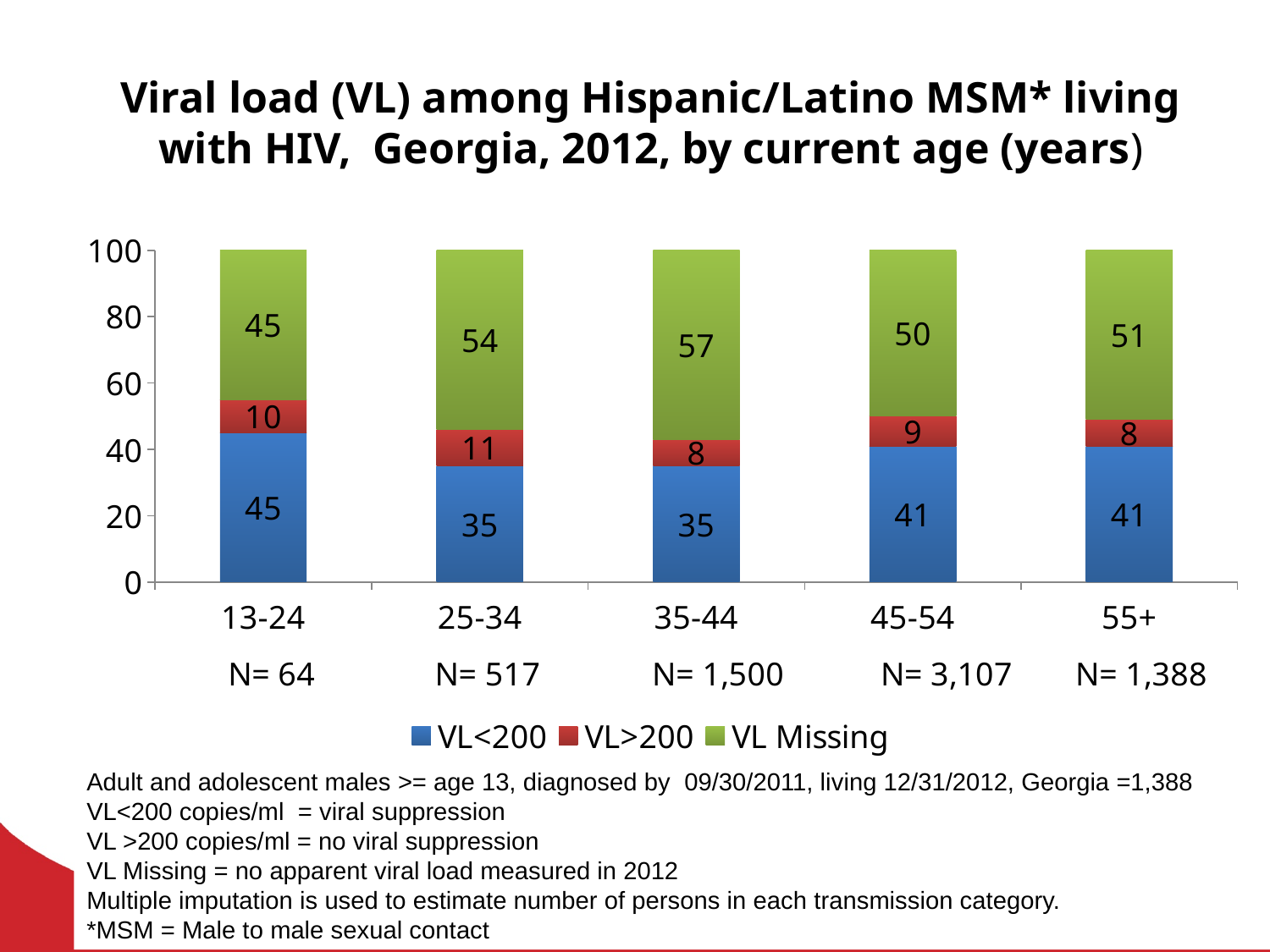
Which age group has the highest VL Missing value? 35-44 What kind of chart is shown on the slide? Stacked bar chart How many age groups are shown on the x axis? 5 Which age group has the lowest VL<200 value? 25-34 and 35-44 (both 35) What is the VL<200 value for the 13-24 age group? 45 What is the difference between the VL Missing values for the 35-44 and 13-24 age groups? 12 Which is larger, the VL>200 value for 25-34 or for 55+? 25-34 What is the VL Missing value for the 35-44 age group? 57 What is the VL>200 value for the 45-54 age group? 9 What is the total of the stacked bar for the 45-54 age group? 100 What is the N shown for the 35-44 age group? N= 1,500 How many series does the legend list? 3